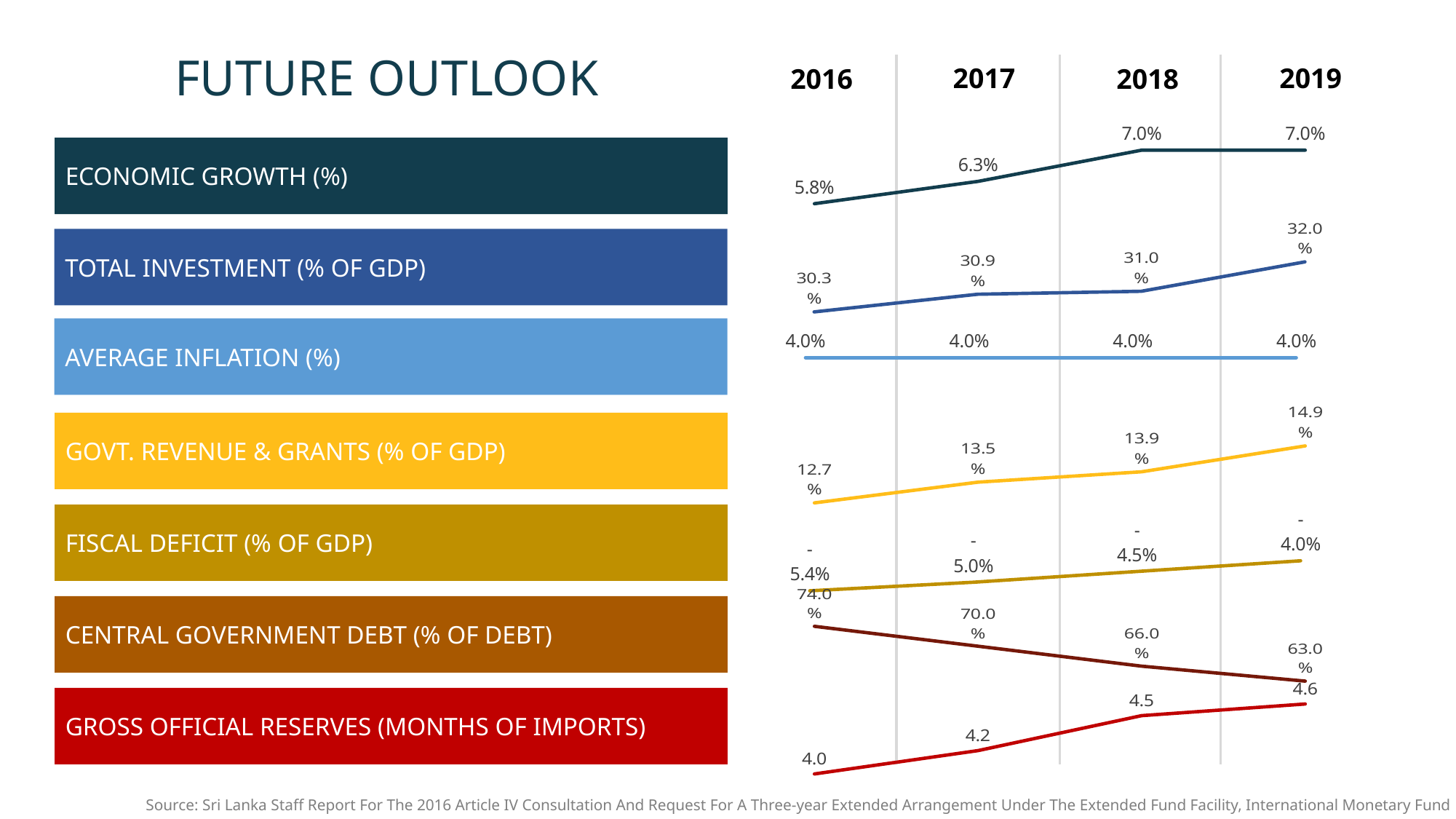
How many years are plotted in the Gross Official Reserves chart? 4 What kind of chart is used to show Economic Growth (%) on the slide? line chart In the Central Government Debt chart, what is the difference between the 2016 and 2019 values? 11.0% In the Economic Growth (%) chart, what is the value for 2017? 6.3% In the Total Investment (% of GDP) chart, what is the value for 2019? 32.0% In the Govt. Revenue & Grants chart, which is larger, the value for 2017 or the value for 2019? 2019 In the Central Government Debt chart, which year has the highest value? 2016 In the Average Inflation (%) chart, do the values rise, fall or stay flat from 2016 to 2019? stay flat In the Gross Official Reserves (months of imports) chart, what is the value for 2018? 4.5 In the Govt. Revenue & Grants (% of GDP) chart, which year has the lowest value? 2016 In the Central Government Debt chart, do the values rise or fall from 2016 to 2019? fall In the Economic Growth (%) chart, what is the difference between the 2018 and 2016 values? 1.2%